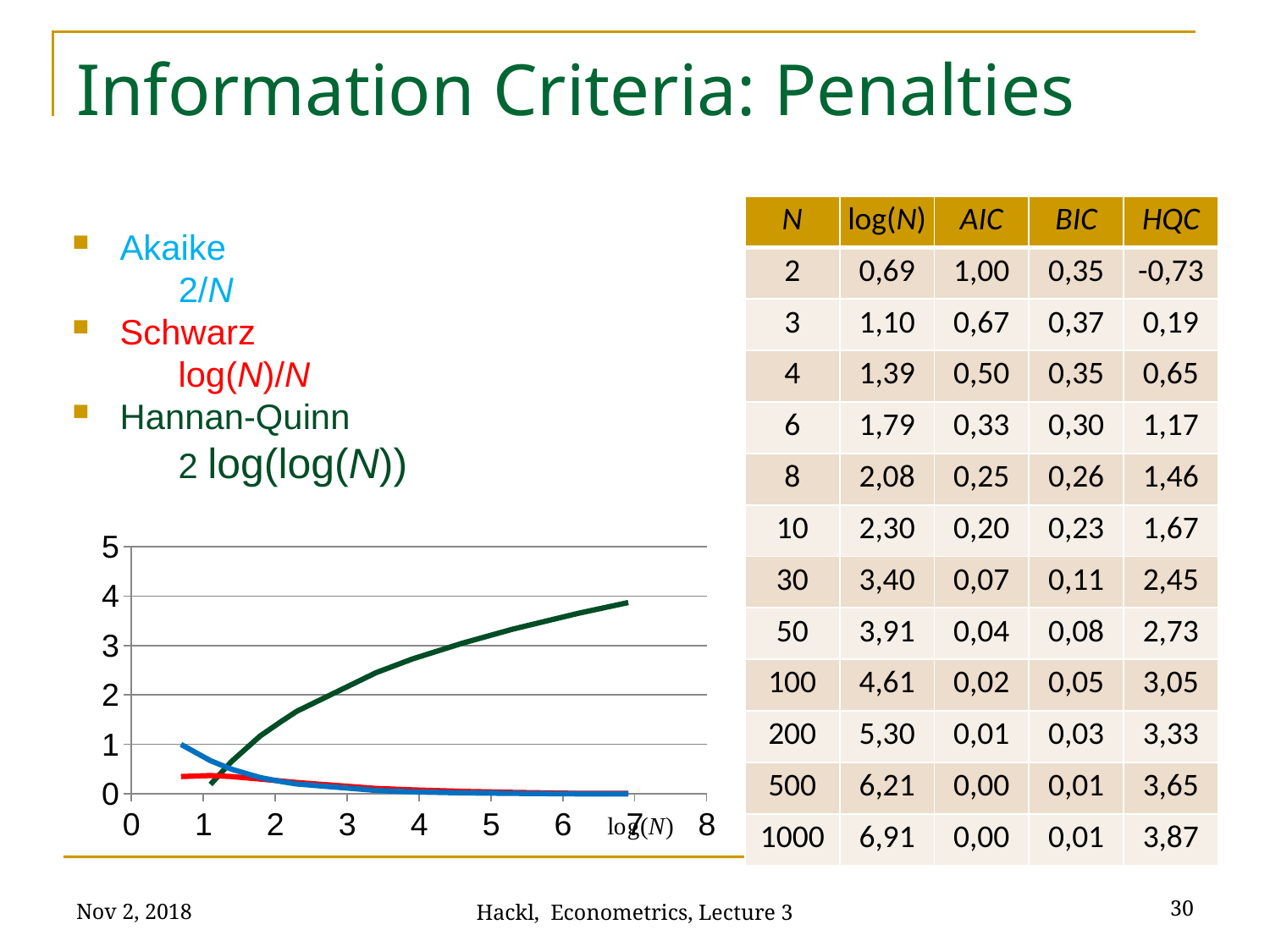
Is the value of the red line at log(N) = 5 greater or less than 1? less Is the value of the blue line at log(N) = 2 greater or less than 1? less What is the highest tick value shown on the x axis of the chart? 8 What is the label on the x axis of the chart? log(N) How many lines are plotted in the chart? 3 What is the highest tick value shown on the y axis of the chart? 5 What kind of chart is shown on the slide? line chart Does the green line rise or fall as log(N) increases? rises Is the value of the green line at log(N) = 2 greater or less than 2? less Which line has the highest value at log(N) = 6? the green line Does the blue line rise or fall as log(N) increases? falls